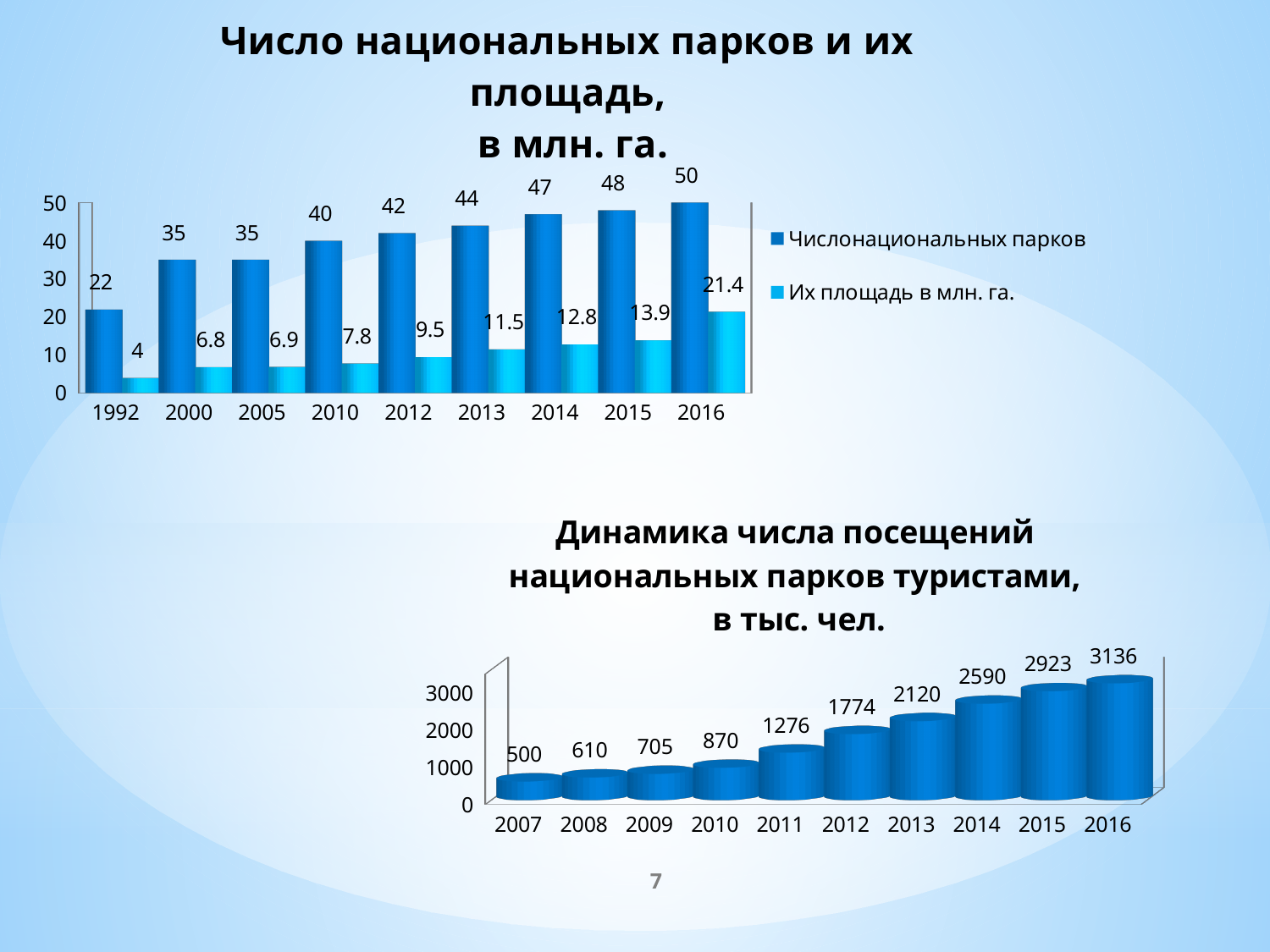
In the bottom chart (Динамика числа посещений национальных парков туристами), which year has the highest number of visits? 2016 In the bottom chart (Динамика числа посещений национальных парков туристами), what is the difference between the values for 2016 and 2015? 213 In the top chart (Число национальных парков и их площадь), how many series does the legend list? 2 In the top chart (Число национальных парков и их площадь), is the area value for 2015 greater or less than 10? greater What kind of chart is the bottom chart (Динамика числа посещений национальных парков туристами)? bar chart In the bottom chart (Динамика числа посещений национальных парков туристами), do the values rise or fall from 2007 to 2016? rise In the top chart (Число национальных парков и их площадь), what is the difference between the number of national parks in 2016 and in 1992? 28 In the bottom chart (Динамика числа посещений национальных парков туристами), what is the number of visits in 2013? 2120 In the top chart (Число национальных парков и их площадь), how many years are shown on the x axis? 9 In the top chart (Число национальных парков и их площадь), what is the number of national parks in 2010? 40 In the top chart (Число национальных парков и их площадь), which year has the lowest area value? 1992 In the top chart (Число национальных парков и их площадь), what is the area in million hectares in 2016? 21.4